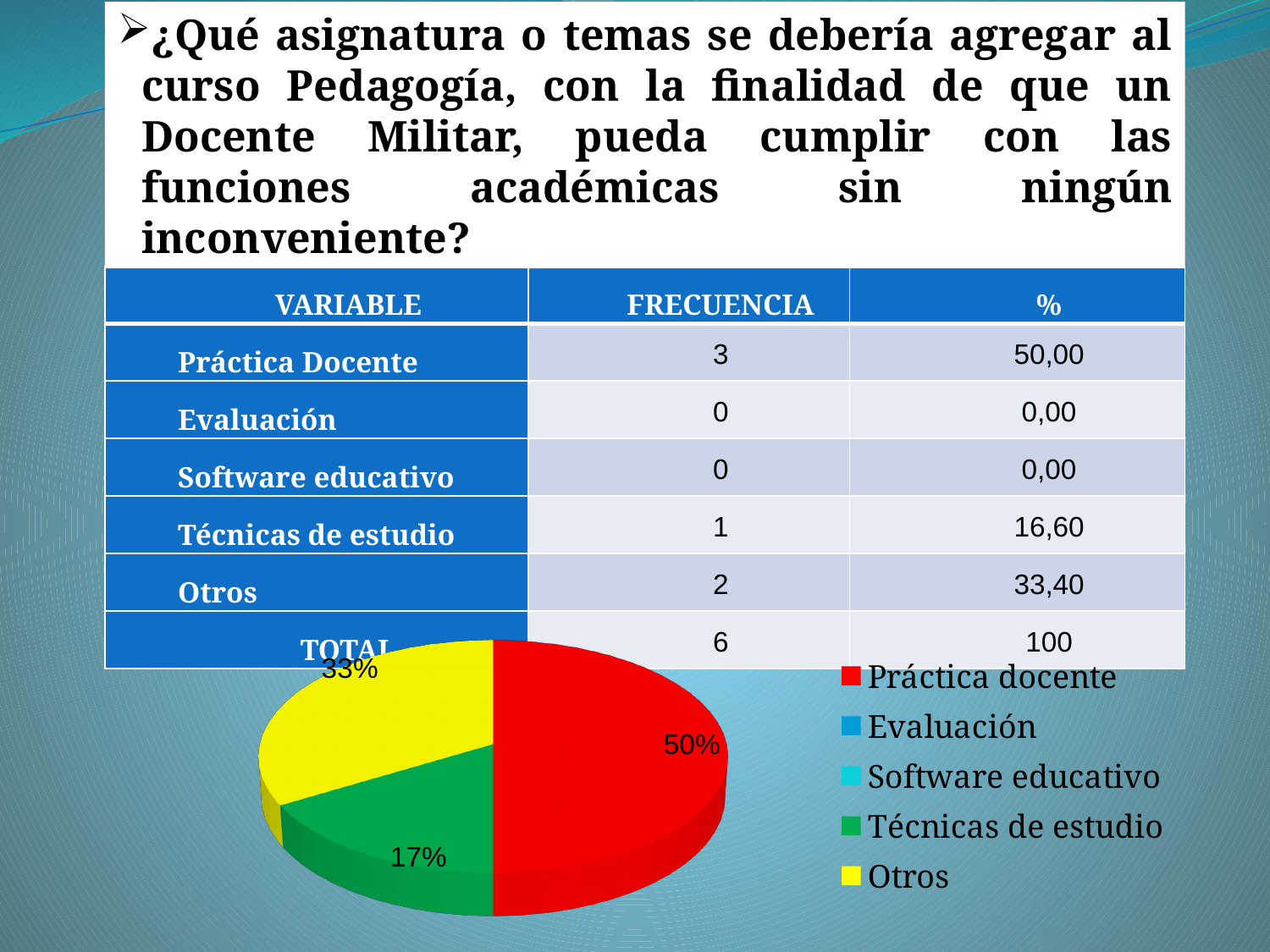
What share of the pie does Práctica docente have? 50% Which of the slices shown in the pie is the smallest? Técnicas de estudio How many slices are visible in the pie chart? 3 How many entries does the pie chart legend list? 5 What share of the pie does Técnicas de estudio have? 17% Which is larger in the pie chart, Otros or Técnicas de estudio? Otros What colour is the Práctica docente slice in the pie chart? red Which category has the largest slice of the pie? Práctica docente What is the difference in percentage points between the Práctica docente slice and the Otros slice? 17% What is the difference in percentage points between the Otros slice and the Técnicas de estudio slice? 16% What kind of chart is shown on the slide? pie chart What share of the pie does Otros have? 33%